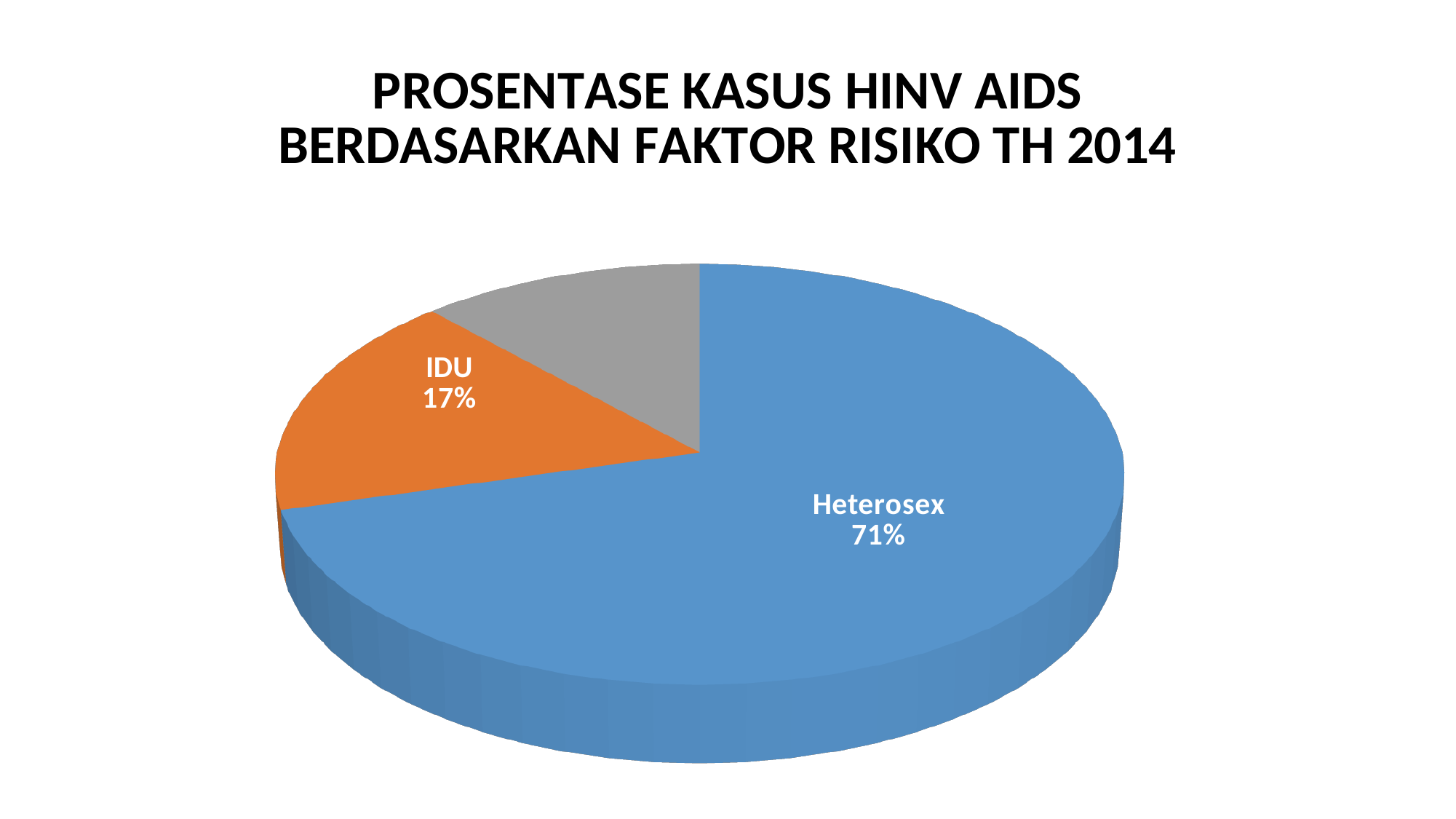
Which labelled category has the largest share of the pie chart? Heterosex Which is larger, the Heterosex share or the IDU share? Heterosex What colour is the Heterosex slice in the pie chart? Blue What percentage does the Heterosex slice represent in the pie chart? 71% By how many percentage points does the Heterosex share exceed the IDU share? 54 percentage points What kind of chart is shown on the slide? Pie chart Which of the two labelled slices, Heterosex or IDU, is smaller? IDU What is the title of the chart? PROSENTASE KASUS HINV AIDS BERDASARKAN FAKTOR RISIKO TH 2014 What share of the pie does the IDU slice take? 17% What percentage does the IDU slice represent in the pie chart? 17% How many slices does the pie chart have? 3